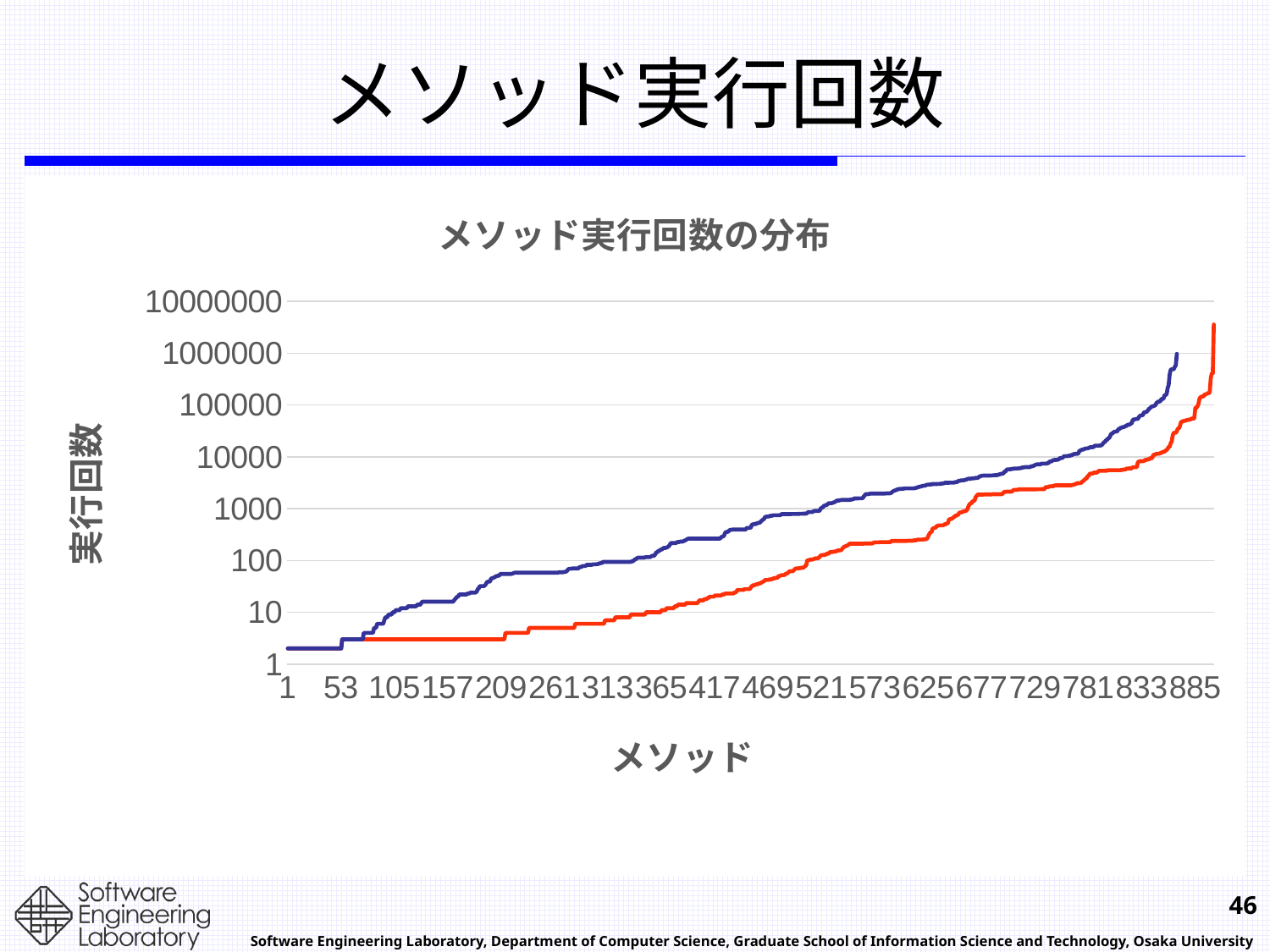
How many lines are plotted on the chart? 2 Is the value of the red line at x = 885 greater or less than 1000000? less At x = 417, which line has the larger value, the blue line or the red line? blue line What is the label of the vertical axis? 実行回数 What is the title of the chart? メソッド実行回数の分布 Do the values of the red line rise or fall as you move along the x axis? rise Is the value of the blue line at x = 417 greater or less than 100? greater At x = 729, which line has the larger value, the blue line or the red line? blue line Is the value of the blue line at x = 209 greater or less than 100? less What kind of chart is shown on the slide? line chart Do the values of the blue line rise or fall as you move along the x axis from 1 to 885? rise